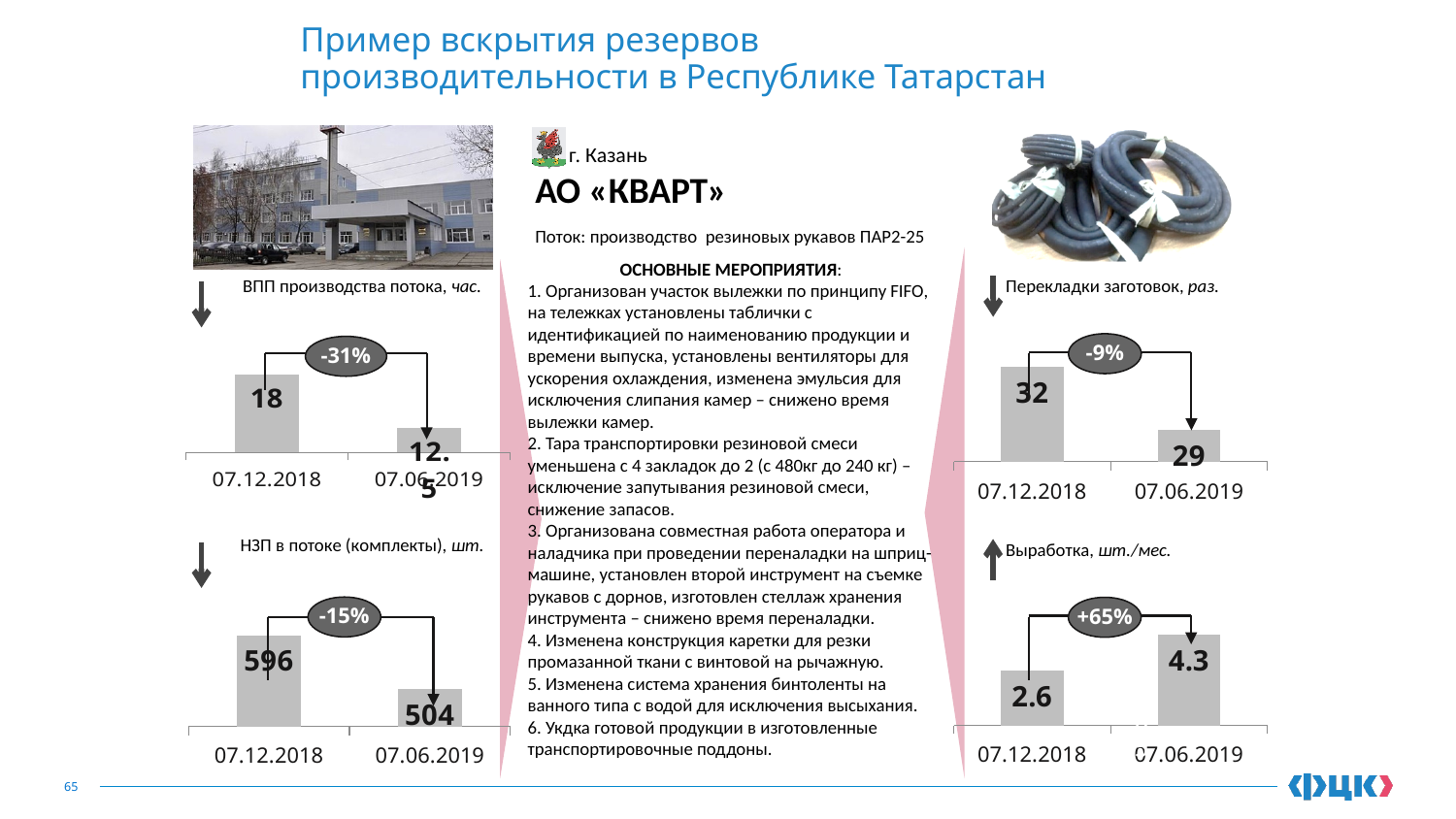
How many bars does the chart 'Перекладки заготовок, раз.' have? 2 In the chart 'НЗП в потоке (комплекты), шт.', what is the difference between the 07.12.2018 and 07.06.2019 values? 92 In the chart 'Выработка, шт./мес.', what is the value for 07.06.2019? 4.3 In the chart 'ВПП производства потока, час.', what percentage change is shown between the two bars? -31% In the chart 'ВПП производства потока, час.', what is the value for 07.12.2018? 18 In the chart 'НЗП в потоке (комплекты), шт.', is the value for 07.12.2018 larger or smaller than the value for 07.06.2019? larger In the chart 'Выработка, шт./мес.', what percentage change is shown between the two bars? +65% In the chart 'Выработка, шт./мес.', do the values rise or fall from 07.12.2018 to 07.06.2019? rise In the chart 'Перекладки заготовок, раз.', what is the value for 07.12.2018? 32 In the chart 'Перекладки заготовок, раз.', which date has the lower value? 07.06.2019 What type of chart is 'ВПП производства потока, час.'? bar chart In the chart 'НЗП в потоке (комплекты), шт.', what is the value for 07.06.2019? 504